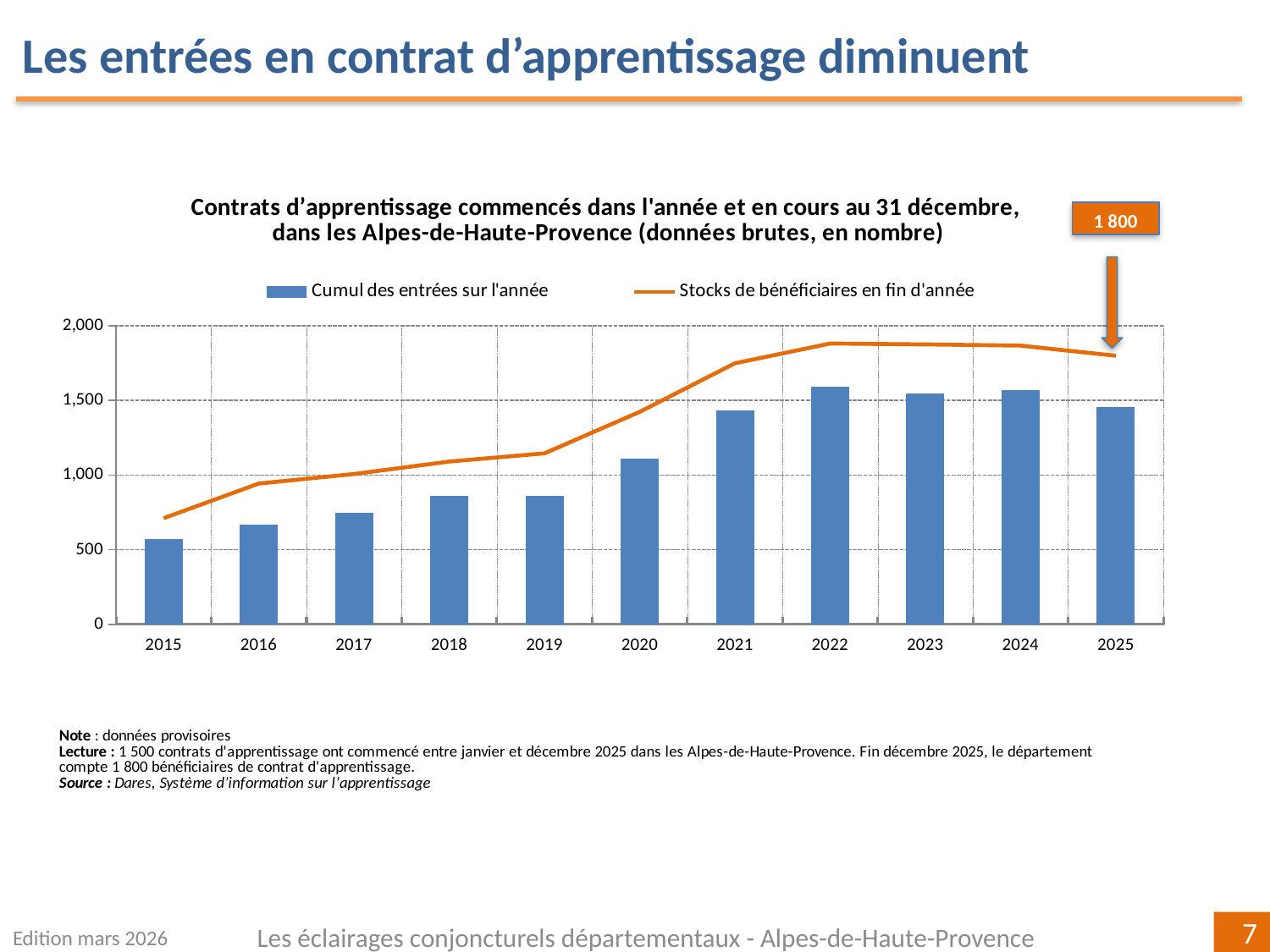
Which year has the lowest bar for 'Cumul des entrées sur l'année'? 2015 How many series does the chart legend list? 2 Which year has the larger 'Cumul des entrées sur l'année' bar, 2020 or 2021? 2021 What kind of chart is shown on the slide? A combined bar and line chart Is the 'Cumul des entrées sur l'année' bar for 2021 greater or less than 1,000? greater What is the value of 'Stocks de bénéficiaires en fin d'année' for 2025, as labelled on the chart? 1 800 How many years are shown on the x axis of the chart? 11 Does the 'Stocks de bénéficiaires en fin d'année' line rise or fall between 2015 and 2022? rise Is the 'Cumul des entrées sur l'année' bar for 2015 greater or less than 1,000? less Which series is drawn as an orange line in the chart? Stocks de bénéficiaires en fin d'année Which year has the larger 'Cumul des entrées sur l'année' bar, 2024 or 2025? 2024 Is the 'Stocks de bénéficiaires en fin d'année' value for 2022 greater or less than 1,500? greater